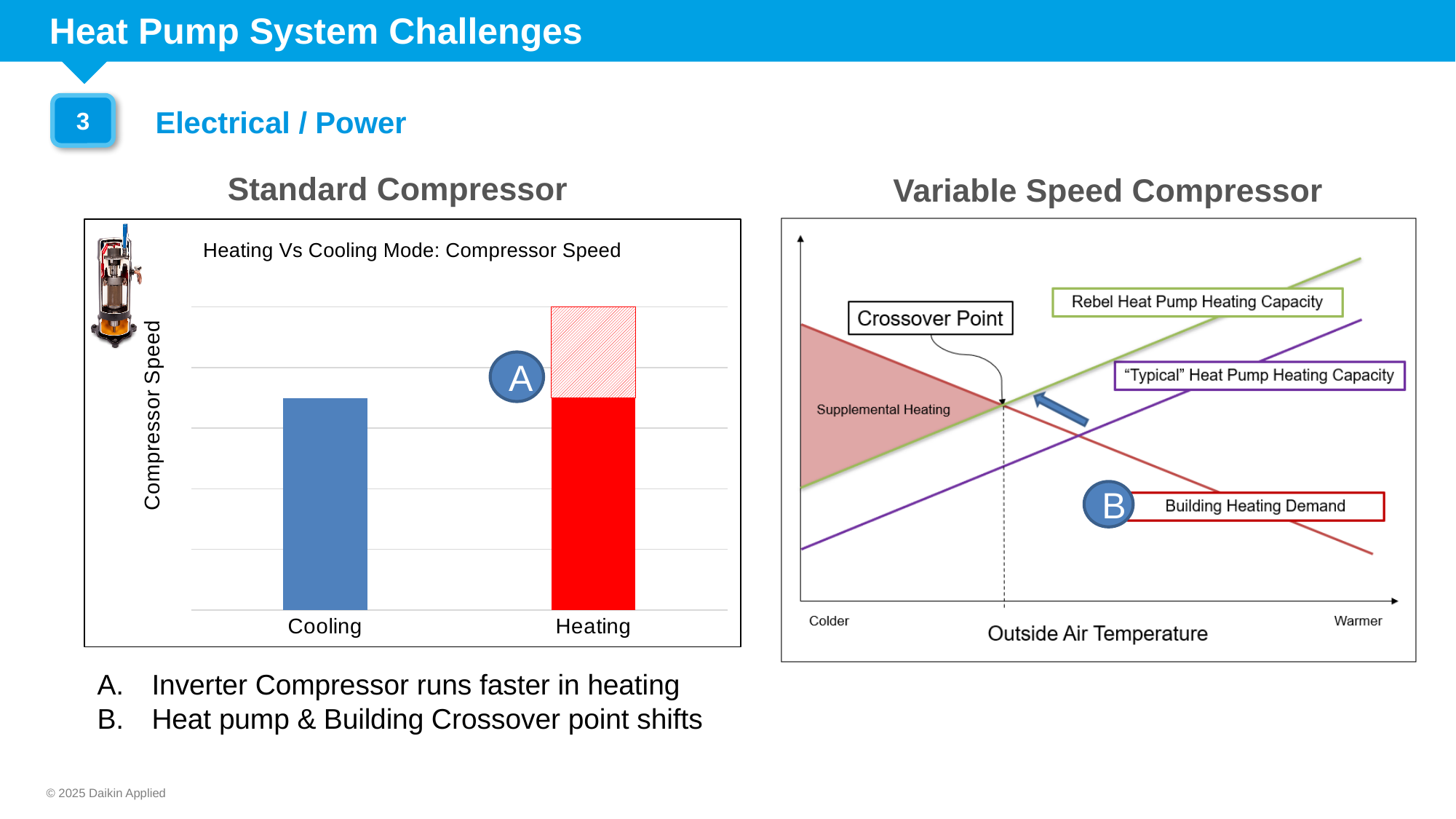
What kind of chart is the Variable Speed Compressor chart on the right? line chart In the Variable Speed Compressor chart on the right, does the Rebel Heat Pump Heating Capacity line rise or fall as outside air temperature gets warmer? rise What kind of chart is the Standard Compressor chart on the left? bar chart How many categories are shown on the x axis of the left bar chart titled 'Heating Vs Cooling Mode: Compressor Speed'? 2 In the Variable Speed Compressor chart on the right, does the Building Heating Demand line rise or fall as outside air temperature gets warmer? fall In the left bar chart 'Heating Vs Cooling Mode: Compressor Speed', which bar extends higher, Cooling or Heating? Heating What is the x-axis label of the Variable Speed Compressor chart on the right? Outside Air Temperature How many lines are plotted in the Variable Speed Compressor chart on the right? 3 What is the y-axis label of the left bar chart 'Heating Vs Cooling Mode: Compressor Speed'? Compressor Speed